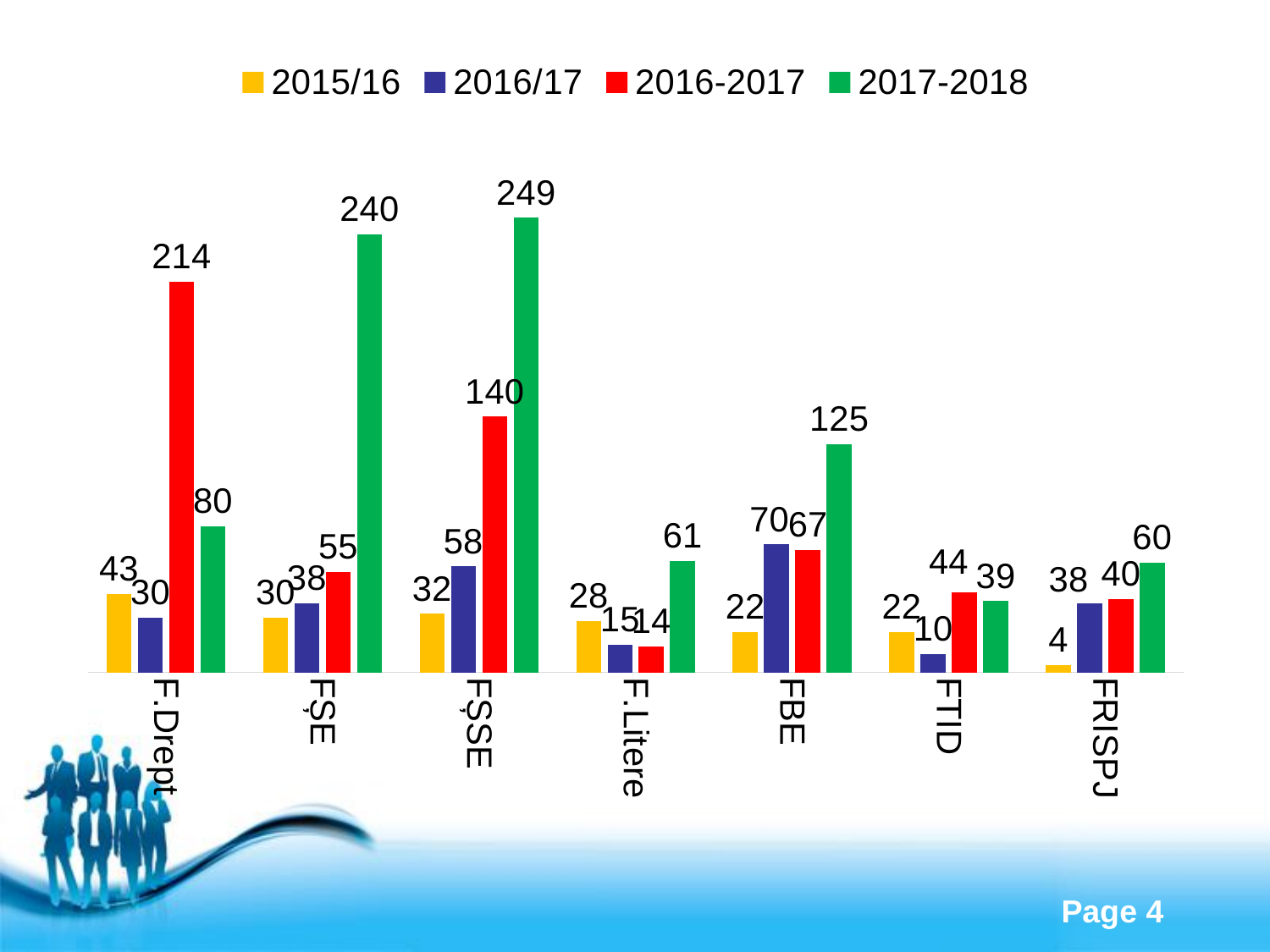
Which is larger for FTID: the 2016-2017 value or the 2017-2018 value? 2016-2017 Which category has the lowest 2015/16 value? FRISPJ What is the 2016/17 value for FBE? 70 What is the 2015/16 value for FRISPJ? 4 What is the 2017-2018 value for FȘSE? 249 What is the 2016-2017 value for F.Drept? 214 What kind of chart is shown on the slide? Bar chart Which colour represents the 2017-2018 series? Green How many categories are shown on the x axis? 7 Which category has the highest 2017-2018 value? FȘSE How many series does the legend list? 4 What is the difference between the 2017-2018 values for FȘE and F.Drept? 160